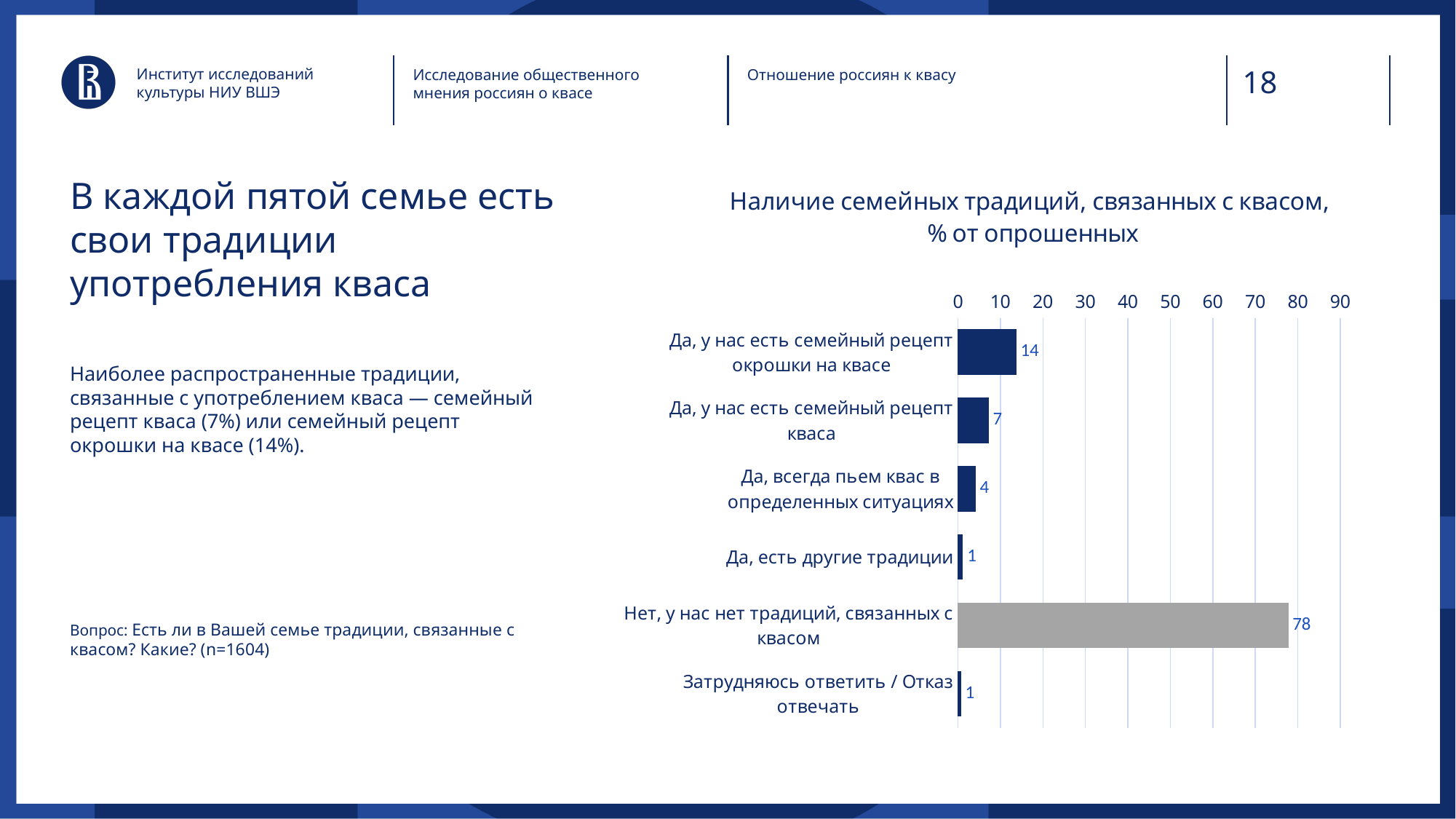
What is the value for "Да, у нас есть семейный рецепт кваса"? 7 What is the value for "Нет, у нас нет традиций, связанных с квасом"? 78 Is the value for "Нет, у нас нет традиций, связанных с квасом" greater or less than 70? greater What is the title of the chart? Наличие семейных традиций, связанных с квасом, % от опрошенных Which bar is coloured grey rather than dark blue? Нет, у нас нет традиций, связанных с квасом Which category has the highest value? Нет, у нас нет традиций, связанных с квасом What is the difference between the values for "Да, у нас есть семейный рецепт окрошки на квасе" and "Да, у нас есть семейный рецепт кваса"? 7 How many categories are shown in the chart? 6 What kind of chart is shown on the slide? bar chart Which is larger: the value for "Да, всегда пьем квас в определенных ситуациях" or the value for "Да, есть другие традиции"? Да, всегда пьем квас в определенных ситуациях What is the value for "Да, всегда пьем квас в определенных ситуациях"? 4 What is the value for "Да, у нас есть семейный рецепт окрошки на квасе"? 14